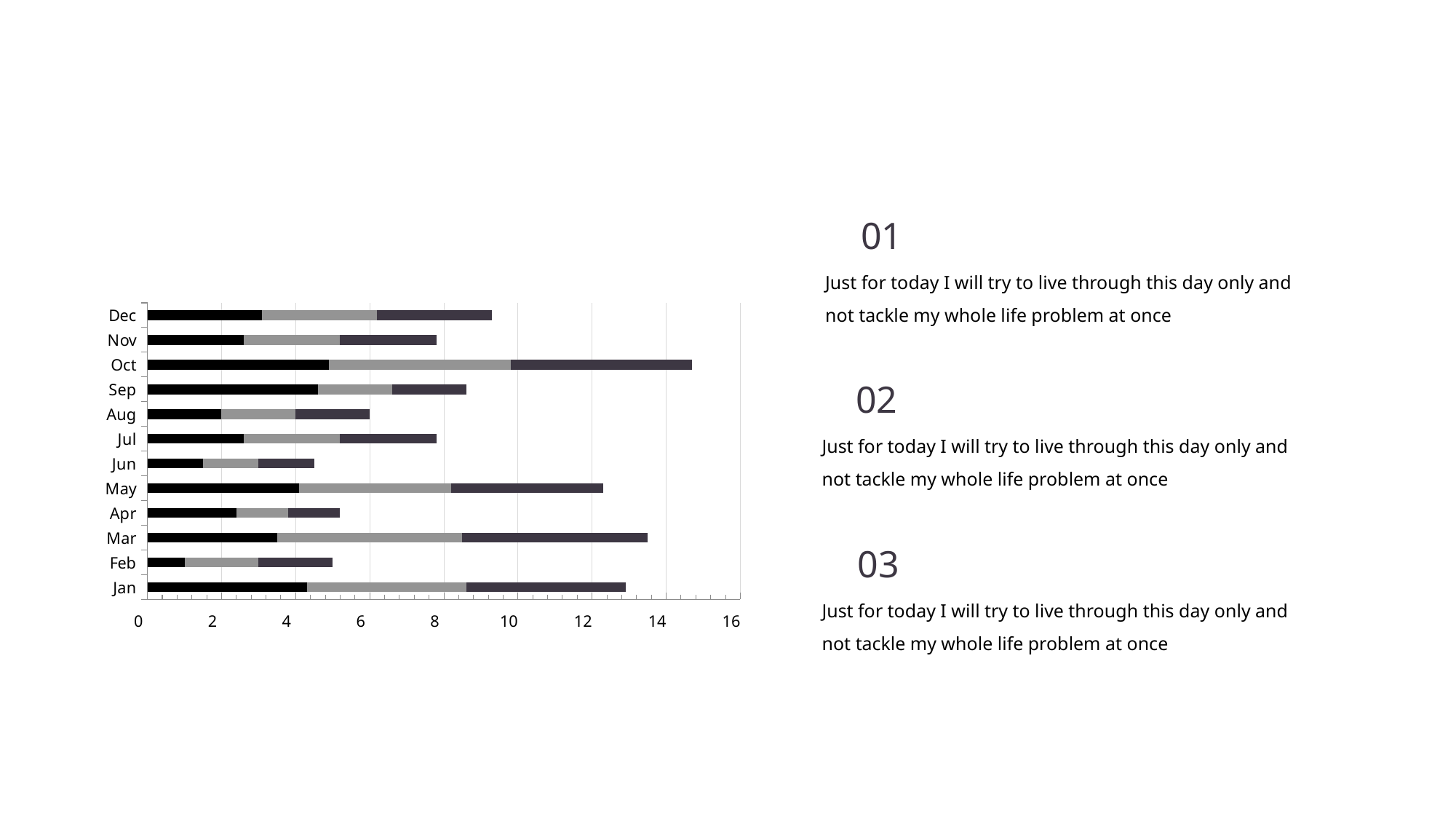
How many months (categories) are plotted on the chart? 12 Is the total bar length for Dec greater or less than 8? greater Is the total bar length for Oct greater or less than 14? greater Is the total bar length for Apr greater or less than 6? less How many coloured segments make up each stacked bar? 3 Which has the longer total bar, Oct or Mar? Oct What kind of chart is shown on the slide? bar chart Which has the longer total bar, May or Dec? May Which month has the longest total bar? Oct